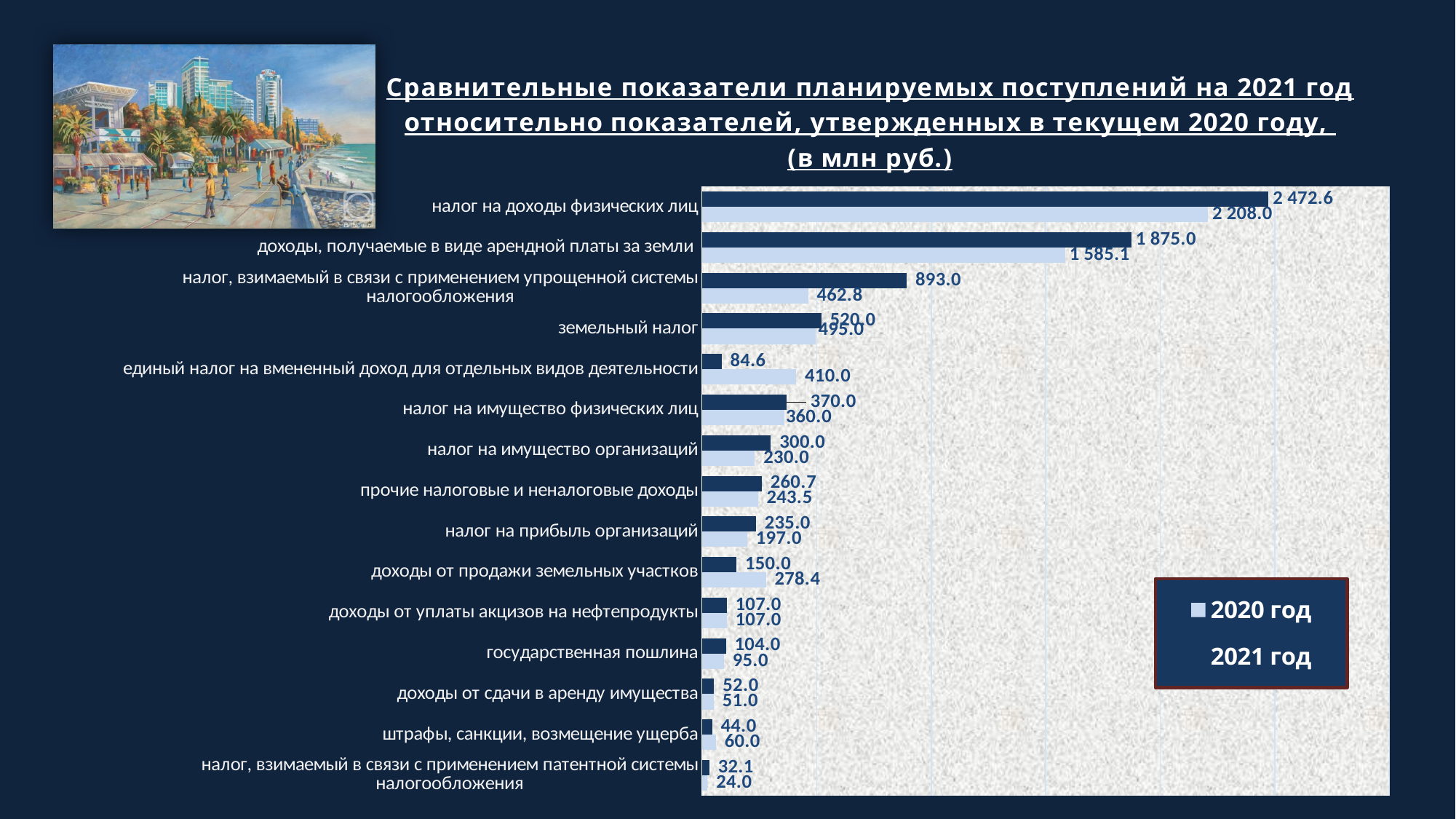
What is the difference between the 2021 год and 2020 год values for налог на имущество организаций? 70.0 What is the 2020 год value for единый налог на вмененный доход для отдельных видов деятельности? 410.0 What is the 2020 год value for доходы от продажи земельных участков? 278.4 How many categories are shown in the chart? 15 Which series is shown in the lighter blue colour? 2020 год What is the 2021 год value for налог на доходы физических лиц? 2 472.6 Which category has the highest 2021 год value? налог на доходы физических лиц How many series does the legend list? 2 Which category has the lowest 2020 год value? налог, взимаемый в связи с применением патентной системы налогообложения What kind of chart is shown on the slide? bar chart What is the 2021 год value for налог, взимаемый в связи с применением упрощенной системы налогообложения? 893.0 For штрафы, санкции, возмещение ущерба, which is larger: the 2020 год value or the 2021 год value? 2020 год